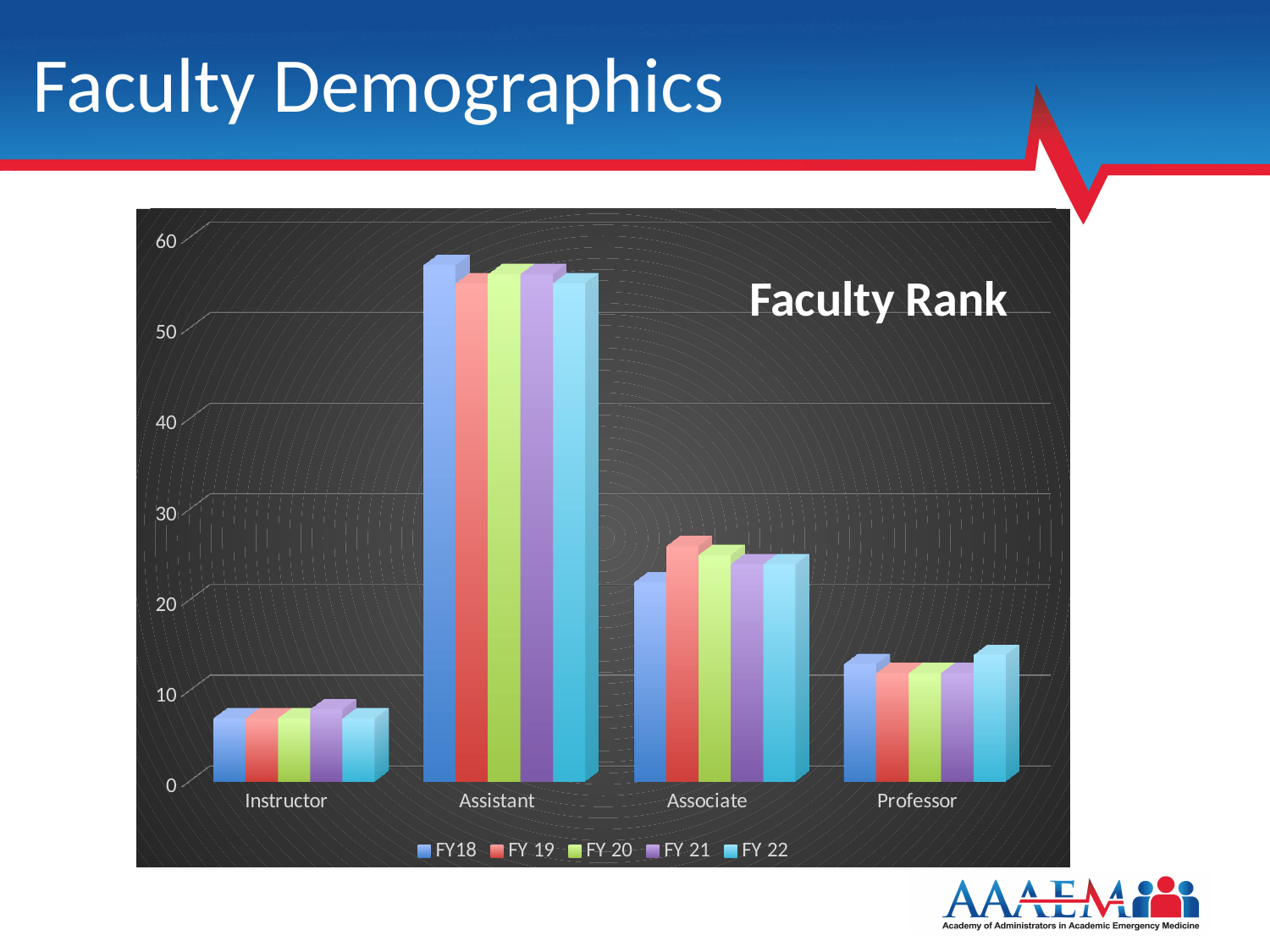
How many series does the legend list? 5 Which faculty rank has the highest values across all fiscal years? Assistant Which faculty rank has the lowest values across all fiscal years? Instructor Which series are listed in the legend? FY18, FY 19, FY 20, FY 21, FY 22 What is the title of the chart? Faculty Rank Is the FY 19 value for Associate greater or less than 20? greater Is the FY 21 value for Instructor greater or less than 10? less For Associate, which is larger: the FY18 value or the FY 19 value? FY 19 Is the FY18 value for Assistant greater or less than 50? greater How many faculty rank categories are shown on the x axis? 4 What kind of chart is shown on the slide? bar chart